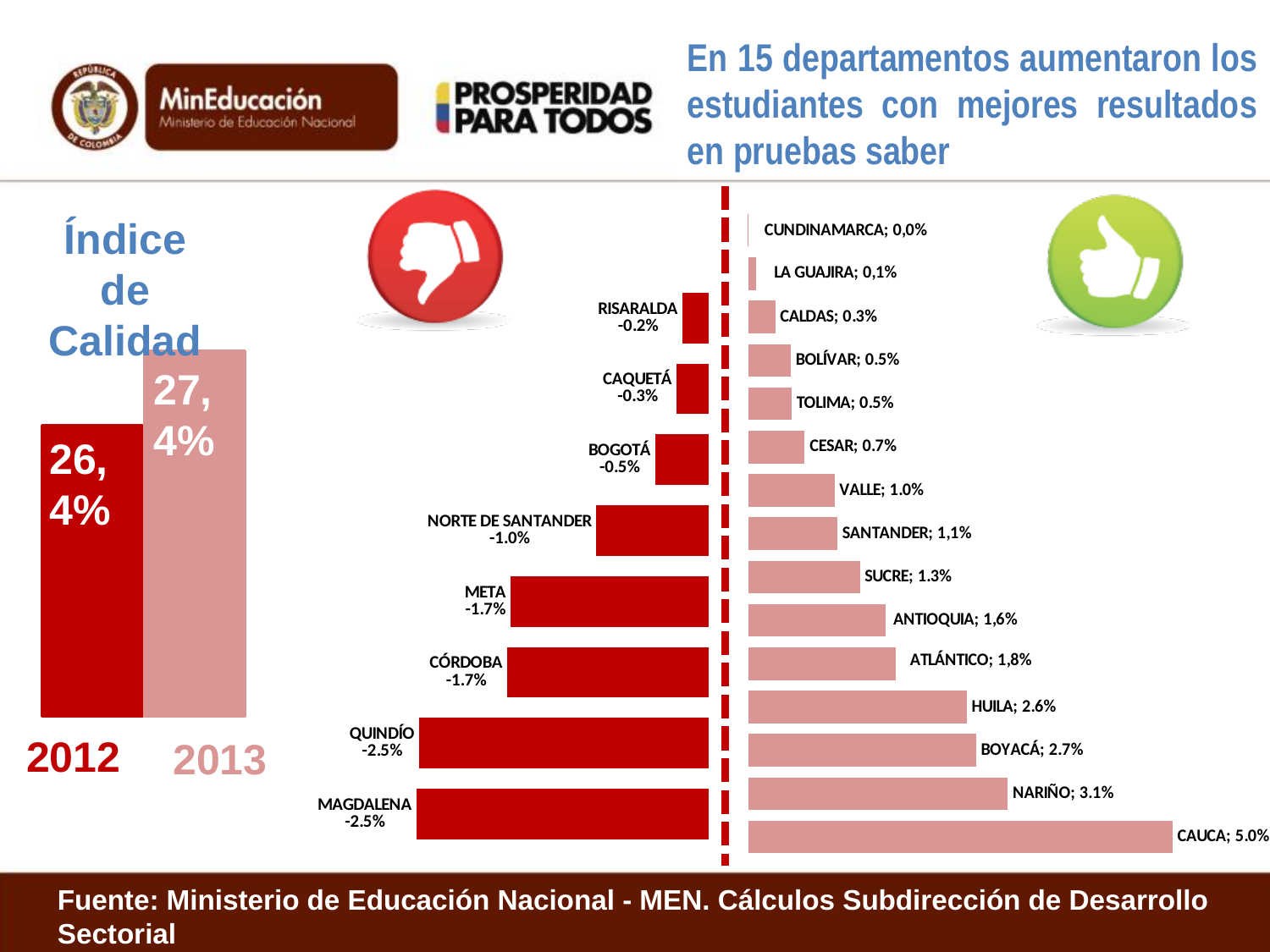
In the Índice de Calidad chart, which year has the higher value, 2012 or 2013? 2013 In the departments chart on the right, which has the larger value, HUILA or VALLE? HUILA In the departments chart on the right, what is the difference between the values for CAUCA and NARIÑO? 1.9 percentage points In the Índice de Calidad chart, what is the value for 2013? 27,4% In the Índice de Calidad chart, what is the value for 2012? 26,4% In the departments chart on the right, what is the value for MAGDALENA? -2.5% In the departments chart on the right, what is the value for ANTIOQUIA? 1,6% In the Índice de Calidad chart, by how many percentage points did the value change from 2012 to 2013? 1 percentage point In the departments chart on the right, what is the value for CAUCA? 5.0% In the departments chart on the right, which department has the highest value? CAUCA What kind of chart is the departments chart on the right? Bar chart In the departments chart on the right, how many departments are shown in total? 23